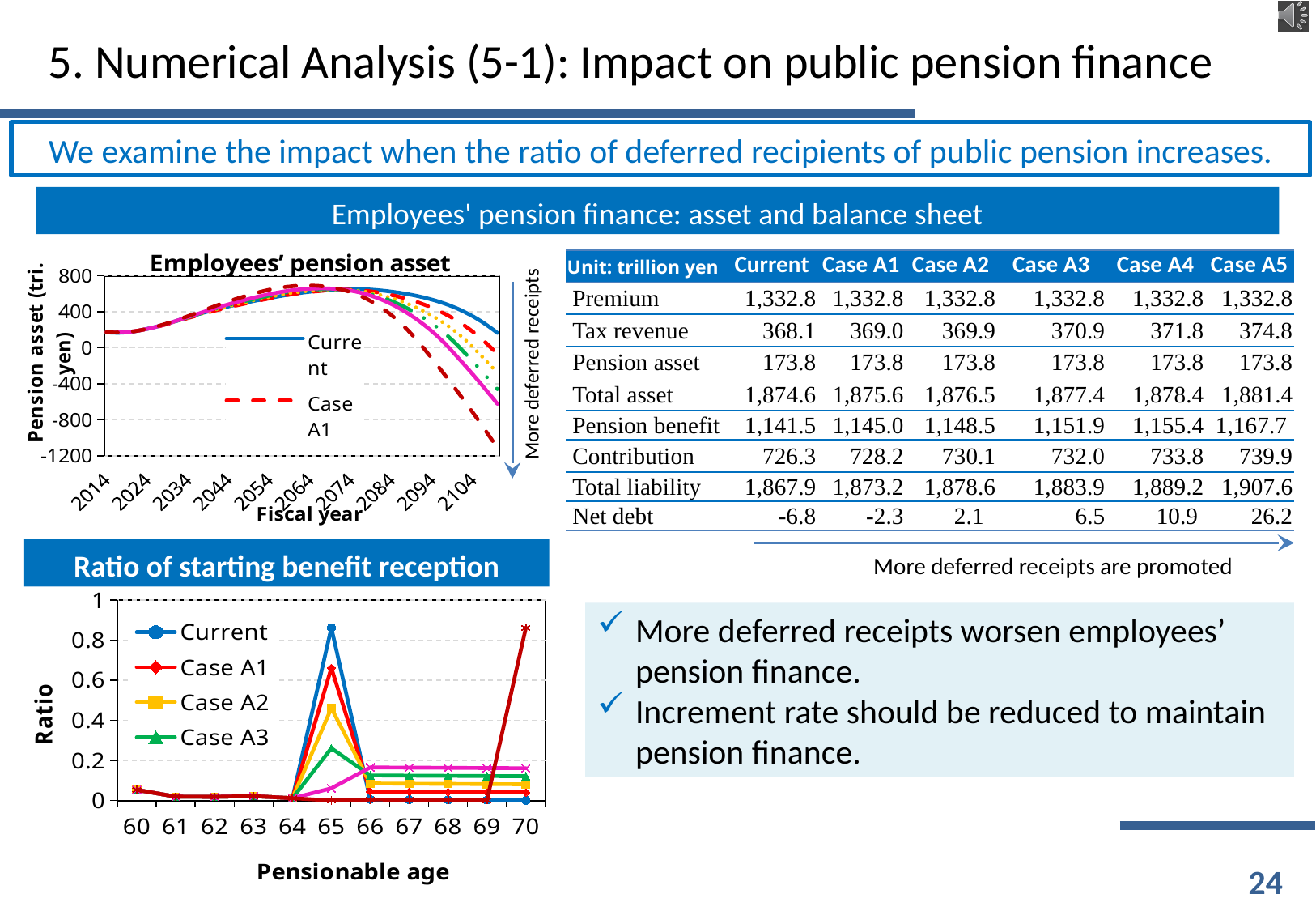
In the "Employees' pension asset" chart, is the value for Current in 2104 greater or less than 0? greater What kind of chart is the "Ratio of starting benefit reception" chart? line chart In the "Ratio of starting benefit reception" chart, at which pensionable age is the Current series highest? 65 In the "Ratio of starting benefit reception" chart, is the value for Current at age 65 greater or less than 0.8? greater In the "Employees' pension asset" chart, what is the label of the x axis? Fiscal year In the "Employees' pension asset" chart, do the values for Current rise or fall between 2084 and 2104? fall In the "Employees' pension asset" chart, is the value for Case A1 in 2104 greater or less than 0? greater In the "Ratio of starting benefit reception" chart, how many pensionable ages are shown on the x axis? 11 In the "Employees' pension asset" chart, which series is higher in 2104, Current or Case A1? Current In the "Employees' pension asset" chart, how many series does the legend list? 2 What kind of chart is the "Employees' pension asset" chart? line chart In the "Ratio of starting benefit reception" chart, how many series does the legend list? 4